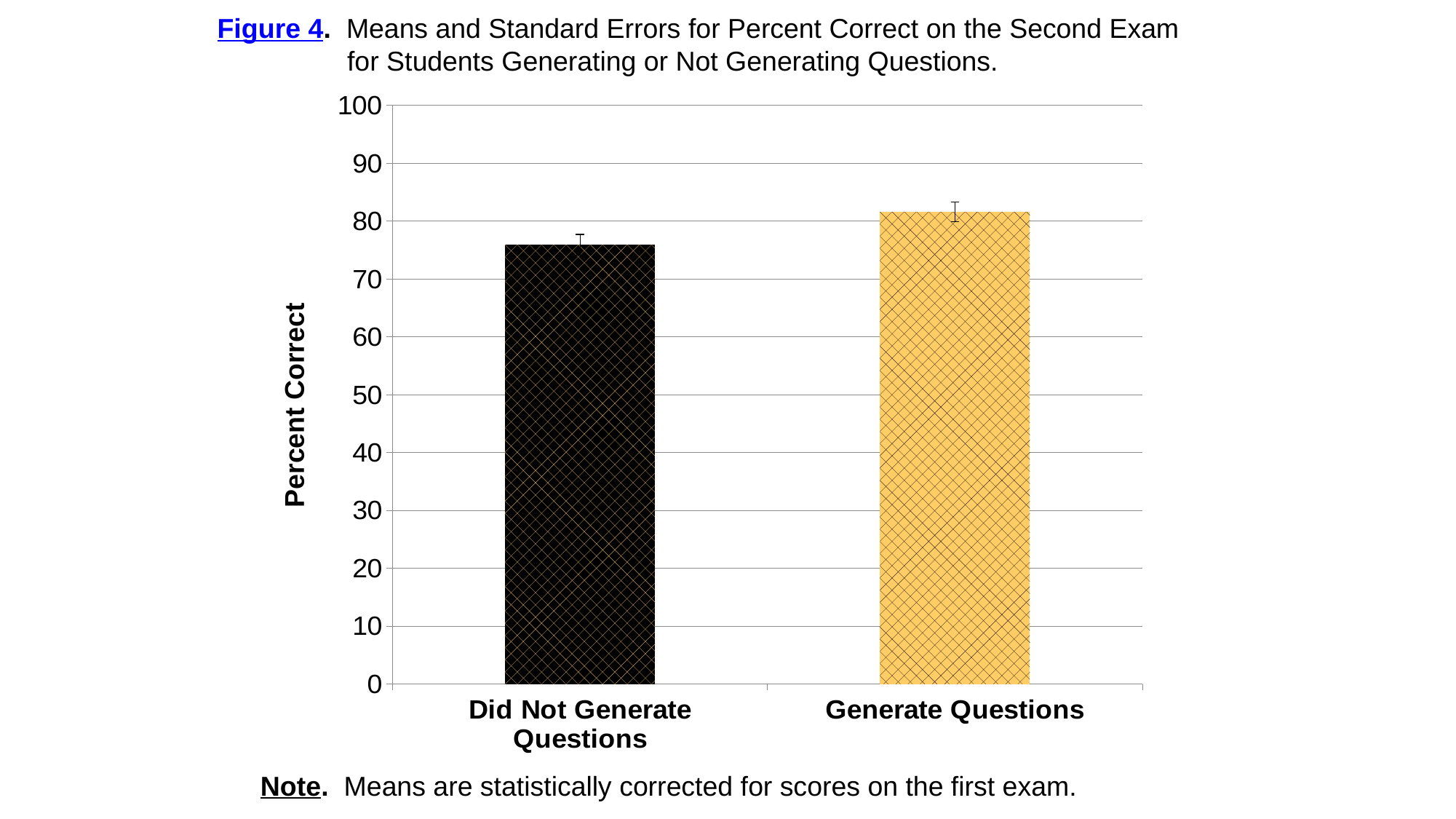
What is the maximum value shown on the y axis? 100 Is the value for Generate Questions greater or less than 80? greater Is the value for Did Not Generate Questions greater or less than 70? greater Which is larger, the value for Generate Questions or the value for Did Not Generate Questions? Generate Questions What is the label of the y axis? Percent Correct How many categories are plotted on the x axis? 2 Is the value for Generate Questions greater or less than 90? less Which category has the highest percent correct? Generate Questions Which category has the lowest percent correct? Did Not Generate Questions What kind of chart is shown on the slide? bar chart